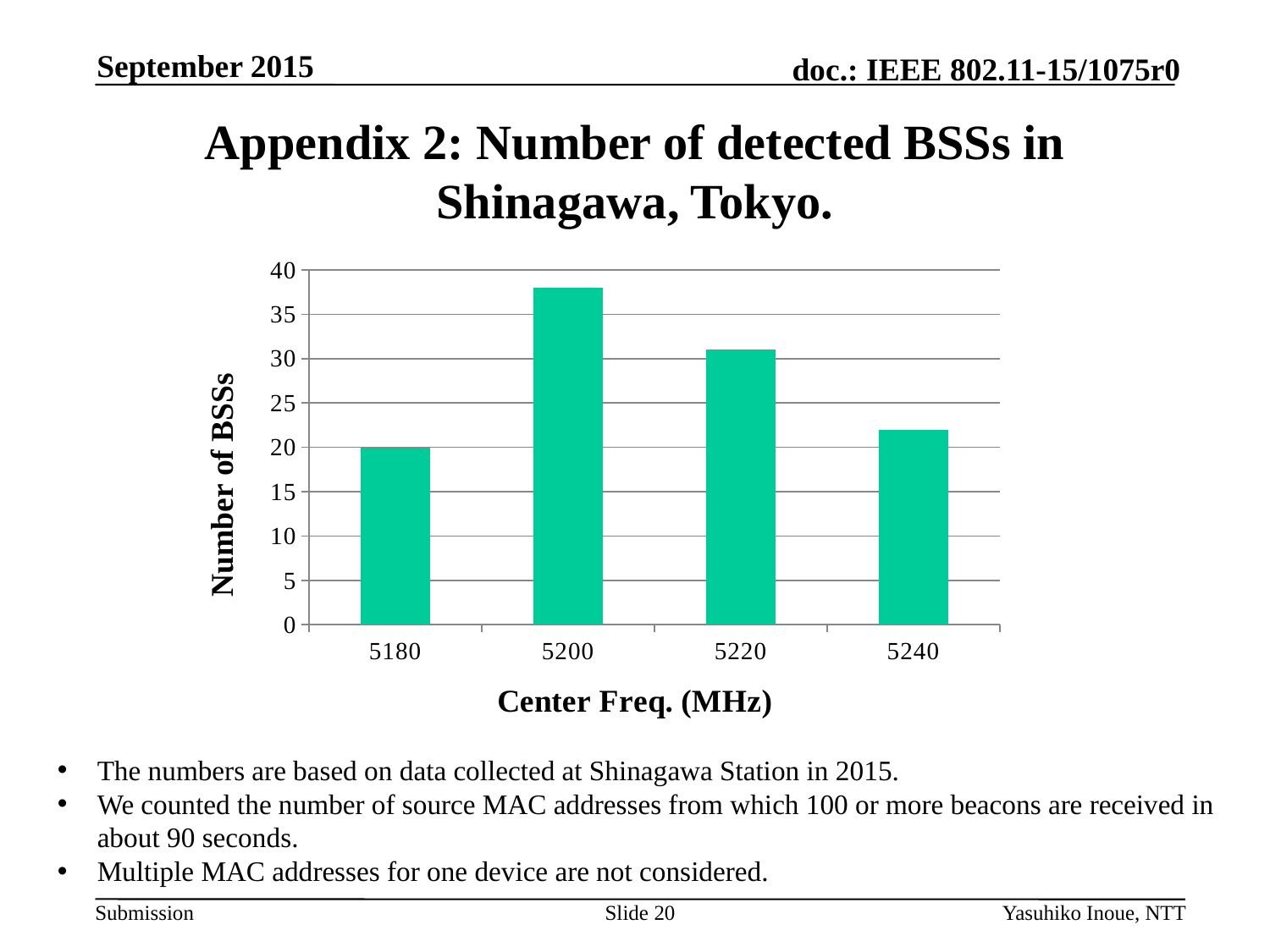
Which has more BSSs, 5220 MHz or 5240 MHz? 5220 MHz What kind of chart is shown on the slide? bar chart Is the number of BSSs at 5240 MHz greater or less than 25? less What is the number of BSSs at 5180 MHz? 20 What is the label of the x axis? Center Freq. (MHz) How many center frequencies are plotted on the x axis? 4 Which center frequency has the highest number of BSSs? 5200 Which has more BSSs, 5200 MHz or 5220 MHz? 5200 MHz Is the number of BSSs at 5200 MHz greater or less than 35? greater What is the label of the y axis? Number of BSSs Which center frequency has the lowest number of BSSs? 5180